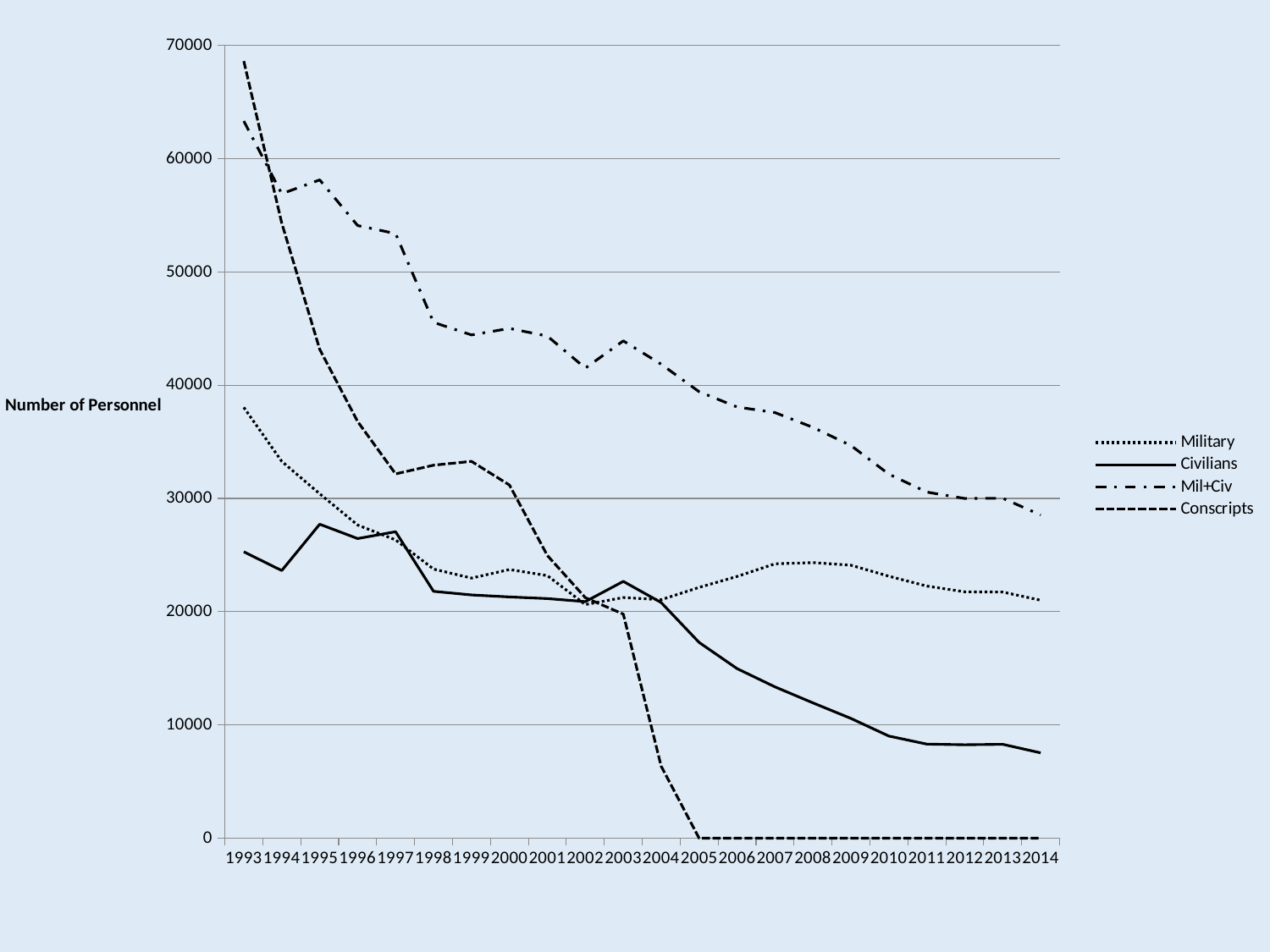
Does the Mil+Civ series rise or fall from 1993 to 2014? fall Is the value for Conscripts in 1993 greater or less than 60000? greater Is the value for Mil+Civ in 1993 greater or less than 60000? greater Is the value for Military in 1993 greater or less than 30000? greater What kind of chart is shown on the slide? line chart In 2010, which is larger: Military or Civilians? Military Which series has the highest value in 2000? Mil+Civ What is the label on the vertical axis? Number of Personnel How many years are shown along the x axis? 22 What is the value for Conscripts in 2010? 0 How many series does the legend list? 4